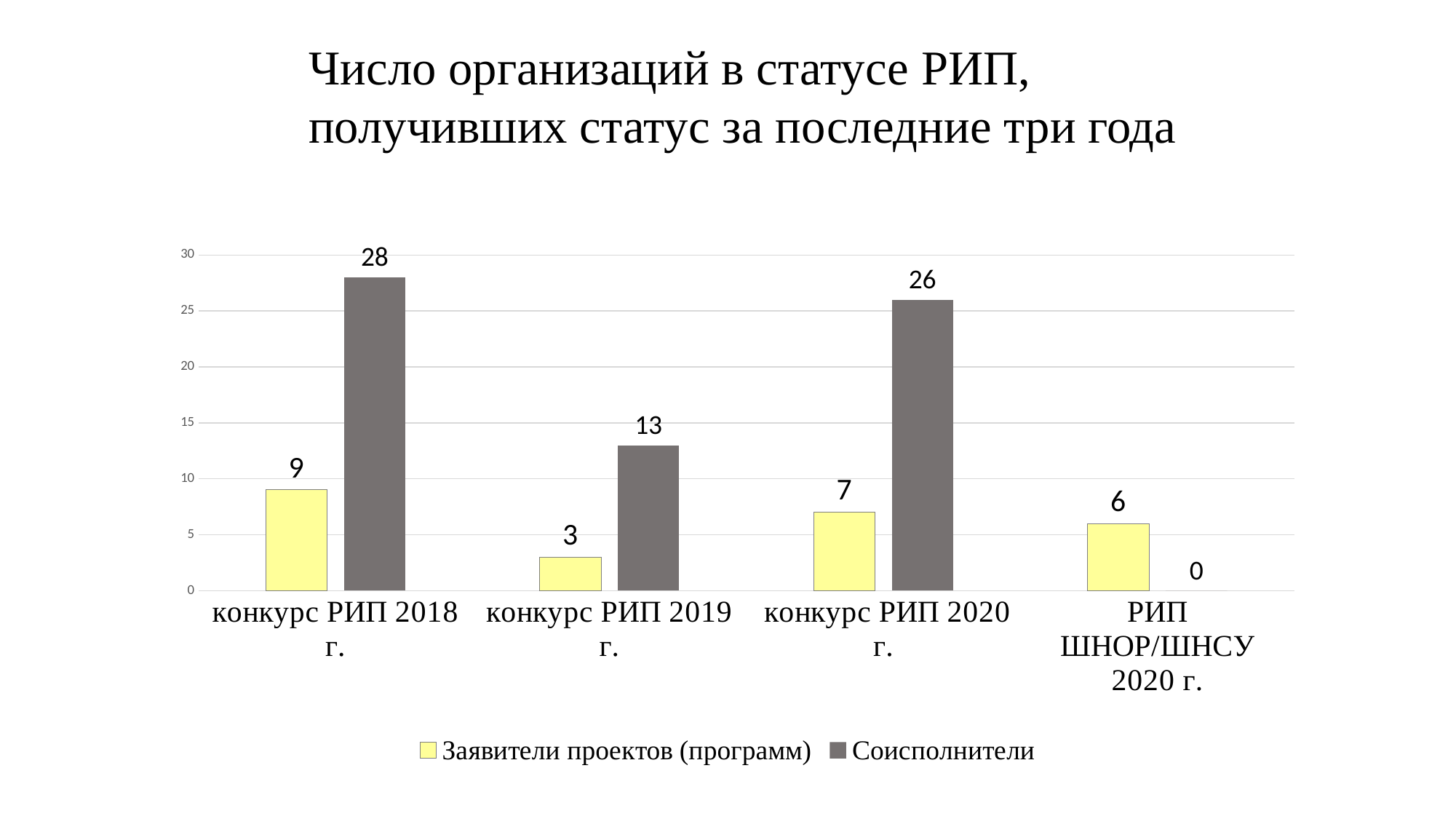
What is the difference between Соисполнители and Заявители проектов (программ) in конкурс РИП 2020 г.? 19 What is the value for Соисполнители in РИП ШНОР/ШНСУ 2020 г.? 0 Which category has the lowest value for Заявители проектов (программ)? конкурс РИП 2019 г. How many series does the legend list? 2 Is the value for Соисполнители in конкурс РИП 2020 г. greater or less than 25? greater What is the value for Соисполнители in конкурс РИП 2019 г.? 13 Which is larger: Заявители проектов (программ) in конкурс РИП 2018 г. or in конкурс РИП 2020 г.? конкурс РИП 2018 г. What colour are the bars for Соисполнители? grey How many categories are shown on the x axis? 4 What kind of chart is shown on the slide? bar chart Which category has the highest value for Соисполнители? конкурс РИП 2018 г. What is the value for Заявители проектов (программ) in конкурс РИП 2018 г.? 9